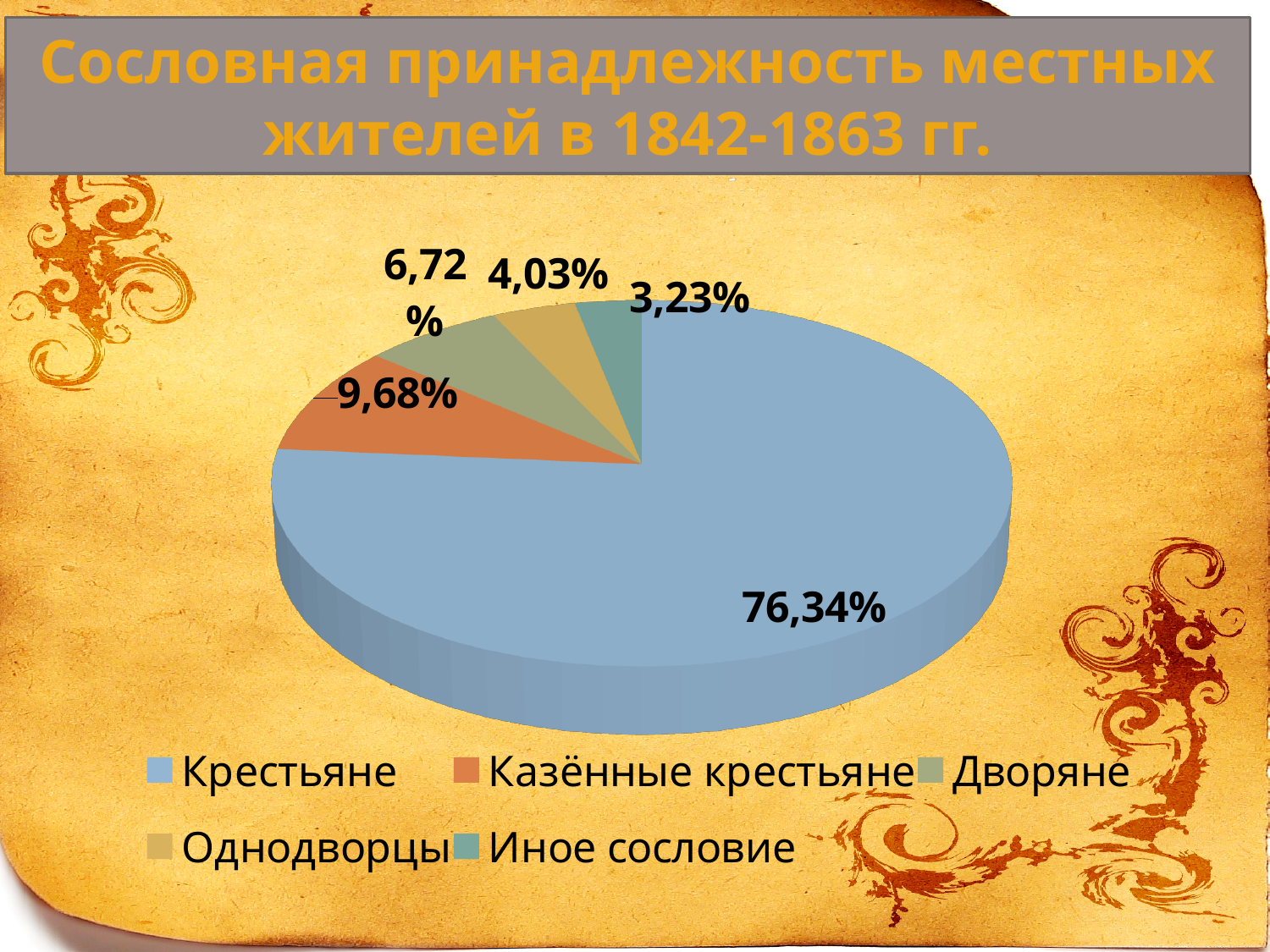
What share of the pie is Казённые крестьяне? 9,68% What share of the pie is Дворяне? 6,72% What is the title of the chart? Сословная принадлежность местных жителей в 1842-1863 гг. How many categories does the legend of the pie chart list? 5 What kind of chart is shown on the slide? pie chart Which category has the smallest slice of the pie? Иное сословие Which is larger: the slice for Казённые крестьяне or the slice for Дворяне? Казённые крестьяне Which category has the largest slice of the pie? Крестьяне What share of the pie is Однодворцы? 4,03% What share of the pie is Крестьяне? 76,34% What share of the pie is Иное сословие? 3,23% What is the difference between the shares of Крестьяне and Казённые крестьяне? 66,66%